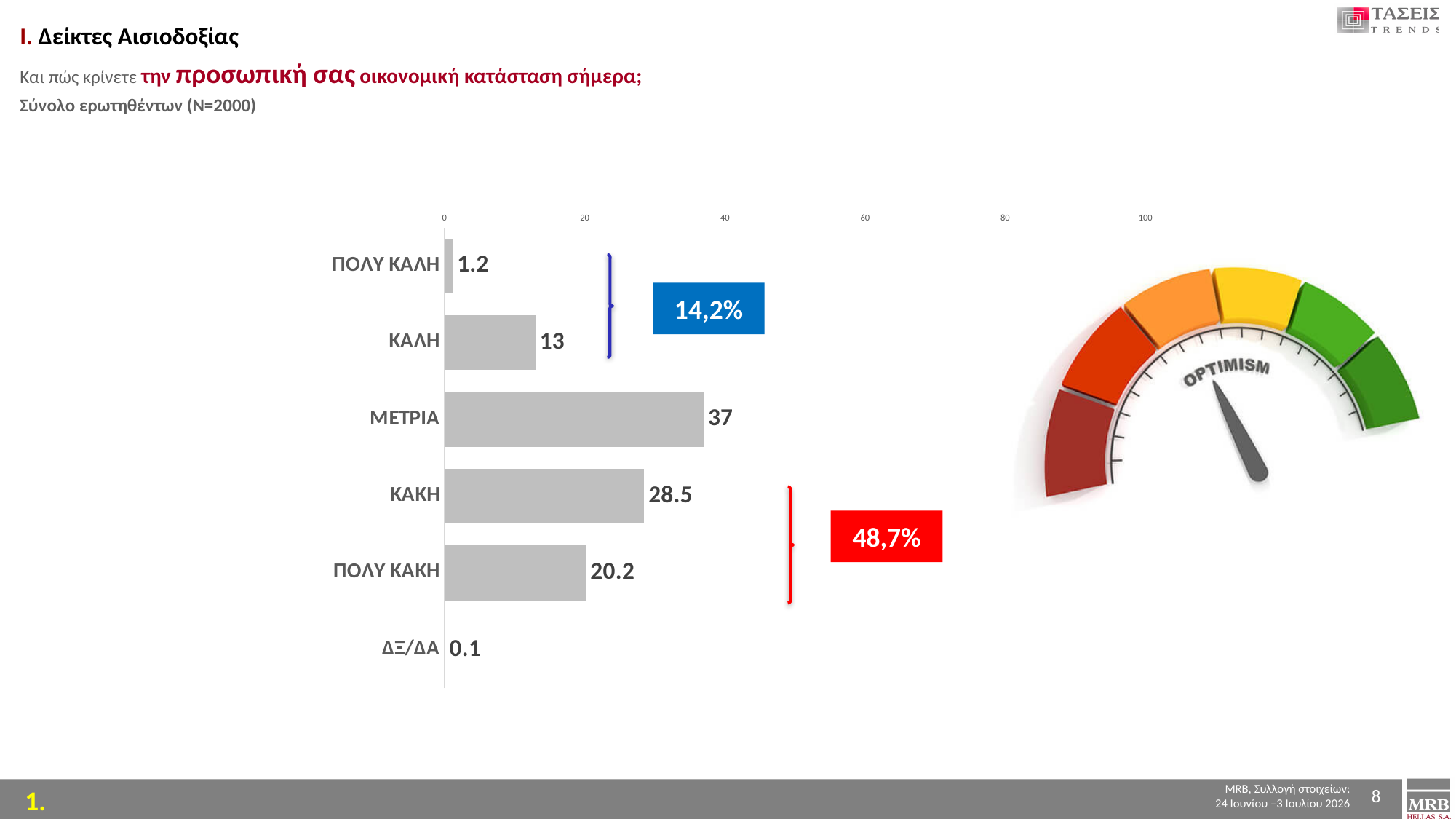
What is the value for ΜΕΤΡΙΑ? 37 What is the difference between the values for ΜΕΤΡΙΑ and ΚΑΚΗ? 8.5 What is the value for ΠΟΛΥ ΚΑΛΗ? 1.2 Which category has the lowest value? ΔΞ/ΔΑ How many categories are shown in the bar chart? 6 What is the value for ΚΑΚΗ? 28.5 What percentage is shown in the red box next to the ΚΑΚΗ and ΠΟΛΥ ΚΑΚΗ bars? 48,7% What is the value for ΚΑΛΗ? 13 Which category has the highest value? ΜΕΤΡΙΑ Which is larger, the value for ΚΑΚΗ or the value for ΠΟΛΥ ΚΑΚΗ? ΚΑΚΗ What is the value for ΠΟΛΥ ΚΑΚΗ? 20.2 What kind of chart is shown on the slide? Bar chart